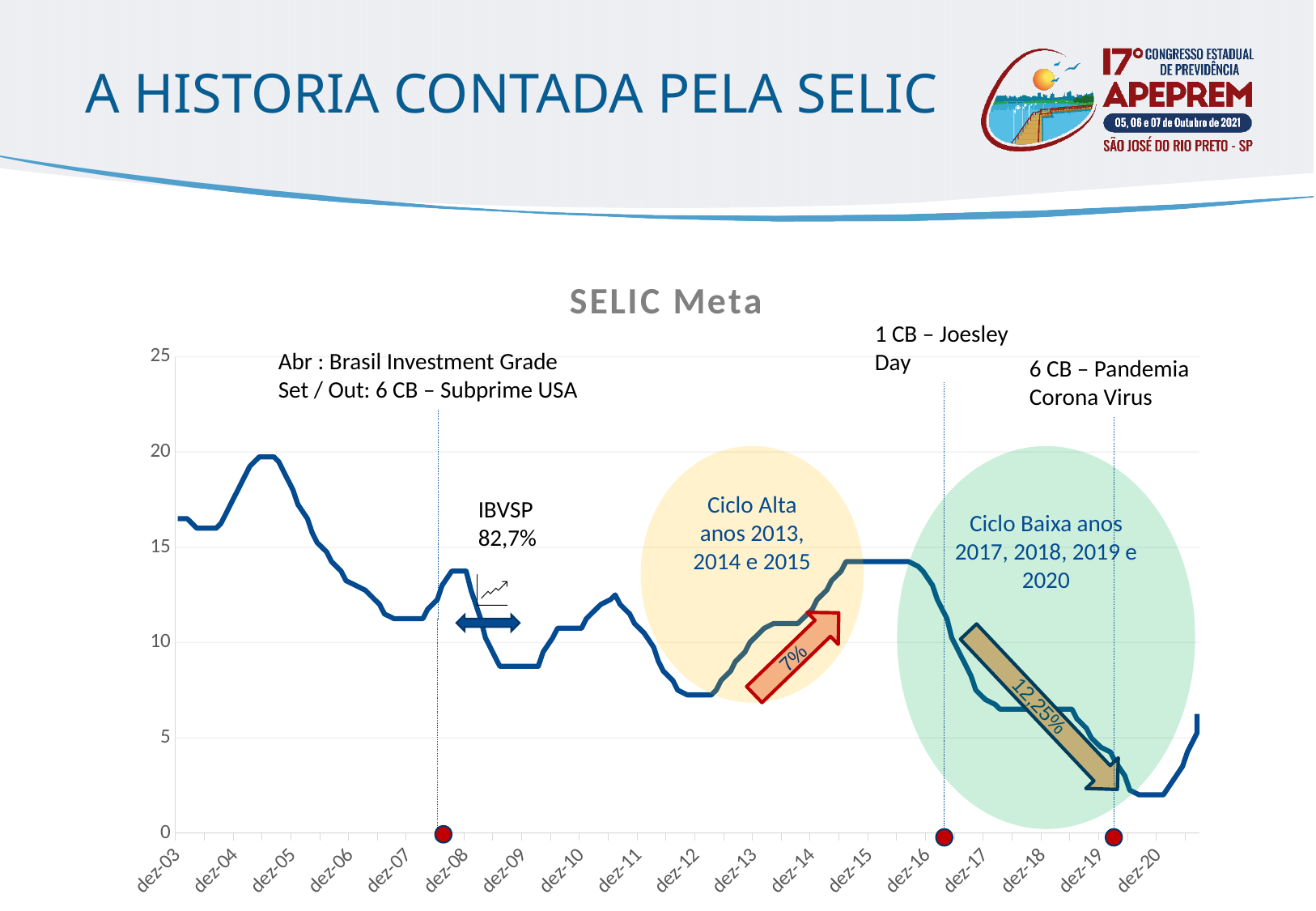
Is the value for dez-12 greater or less than 10? less Is the value for dez-05 greater or less than 15? greater How many x-axis labels are shown on the chart? 18 Is the value for dez-20 greater or less than 5? less What percentage is written on the downward arrow in the 'Ciclo Baixa' region? 12,25% Which is larger, the value for dez-08 or the value for dez-12? dez-08 What is the title of the chart? SELIC Meta What kind of chart is shown on the slide? line chart Does the line rise or fall between dez-12 and dez-15? rise Does the line rise or fall between dez-16 and dez-19? fall